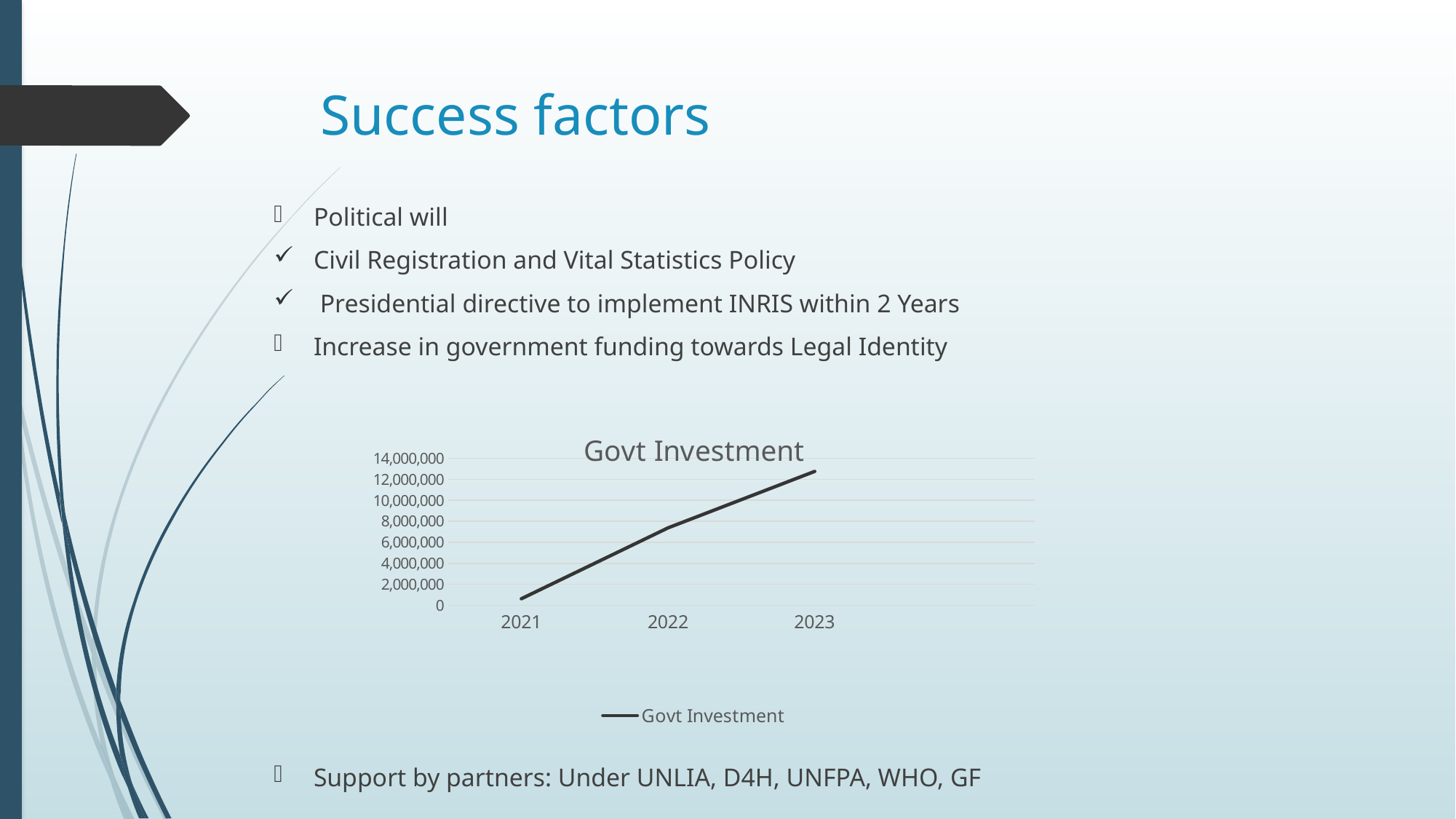
Is the Govt Investment value for 2021 greater or less than 2,000,000? less How many series does the chart legend list? 1 Which year has the highest Govt Investment value? 2023 What is the title of the chart? Govt Investment Is the Govt Investment value for 2023 greater or less than 12,000,000? greater Is the Govt Investment value for 2022 greater or less than 6,000,000? greater Which year has the larger Govt Investment value, 2021 or 2022? 2022 Which year has the lowest Govt Investment value? 2021 How many years are plotted on the x axis of the chart? 3 What kind of chart is shown on the slide? line chart Do the Govt Investment values rise or fall from 2021 to 2023? rise